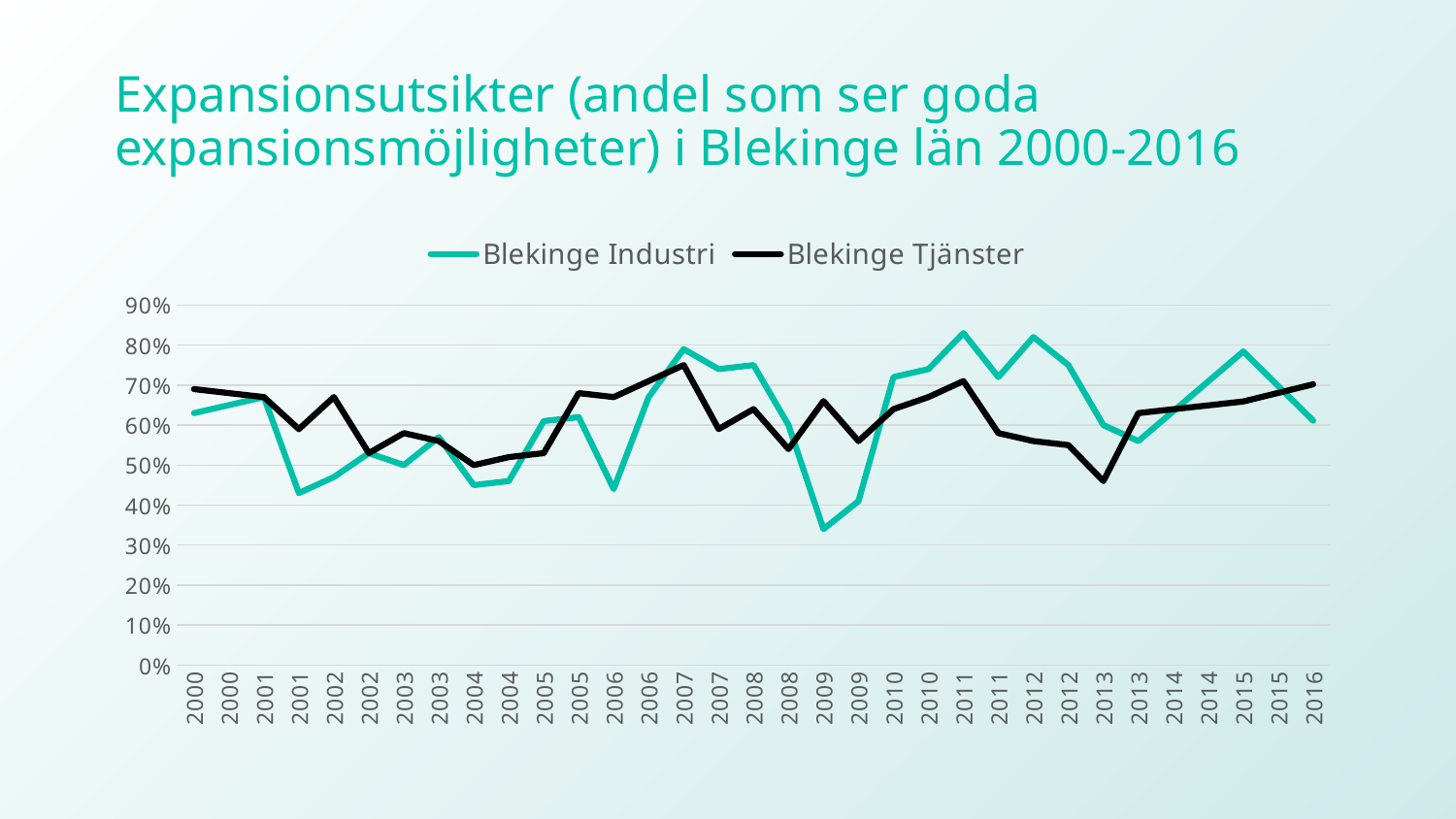
Does the Blekinge Tjänster line rise or fall from the first 2013 point to 2016? Rise Which two series are listed in the legend? Blekinge Industri and Blekinge Tjänster Is the value for Blekinge Tjänster at the first 2007 point greater or less than 70%? greater At which x-axis point does Blekinge Tjänster reach its lowest value? 2013 (first point) How many series does the legend list? 2 At the first 2011 point, which series has the higher value, Blekinge Industri or Blekinge Tjänster? Blekinge Industri What colour is the line for Blekinge Tjänster? Black Is the value for Blekinge Industri at the first 2011 point greater or less than 80%? greater At the first 2009 point, which series has the higher value, Blekinge Industri or Blekinge Tjänster? Blekinge Tjänster Is the value for Blekinge Tjänster at the first 2013 point greater or less than 50%? less What kind of chart is shown on the slide? Line chart